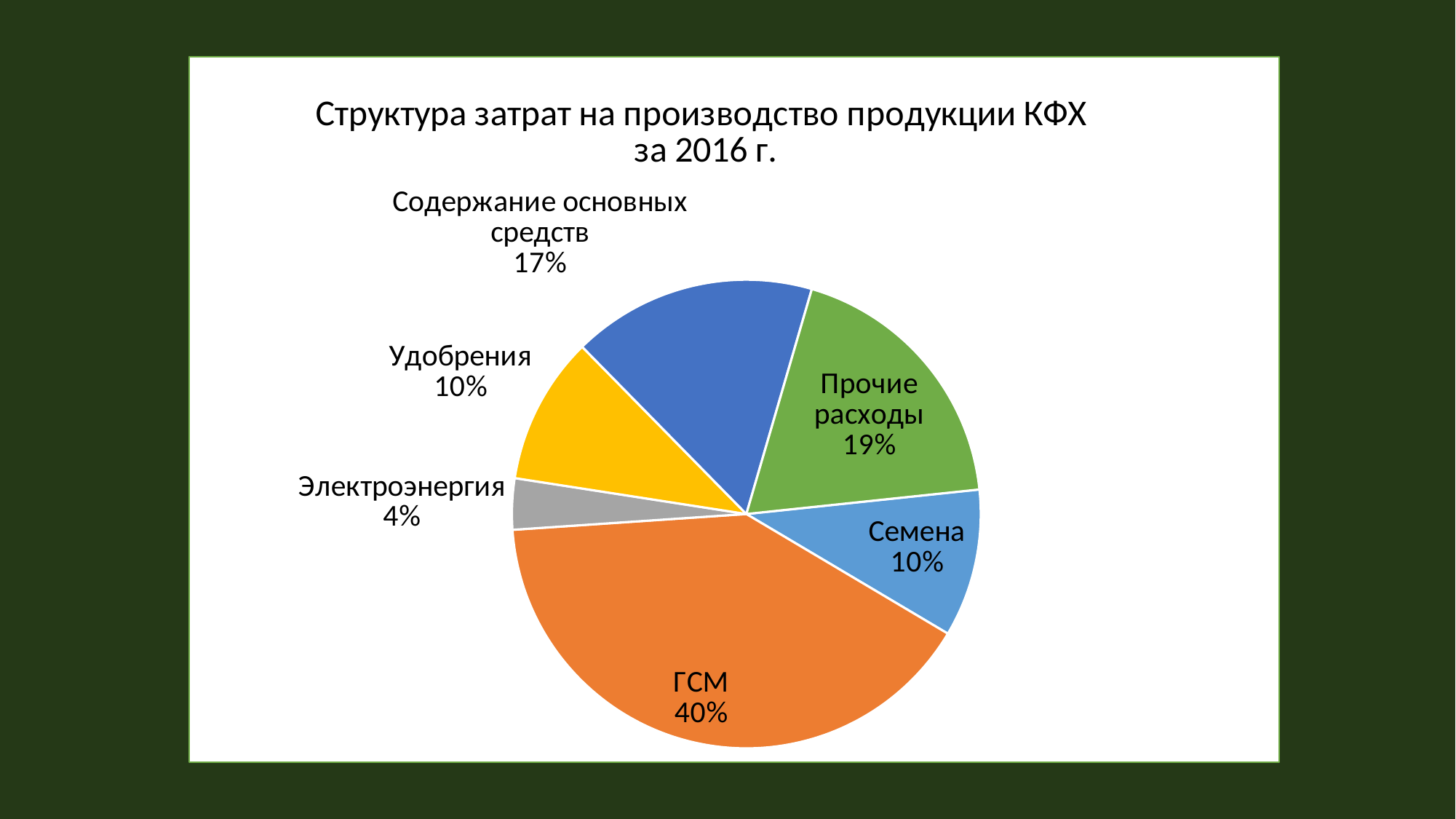
Which is larger, the share for Прочие расходы or the share for Содержание основных средств? Прочие расходы What is the value for Электроэнергия? 4% Which category has the largest share of the pie? ГСМ What type of chart is shown on the slide? pie chart What is the title of the chart? Структура затрат на производство продукции КФХ за 2016 г. What share of costs does ГСМ account for? 40% What is the combined share of Удобрения and Семена? 20% How many categories are shown in the pie chart? 6 What percentage is shown for Содержание основных средств? 17% What is the value shown for Прочие расходы? 19% Which category has the smallest share of the pie? Электроэнергия What is the difference between the shares of ГСМ and Прочие расходы? 21%